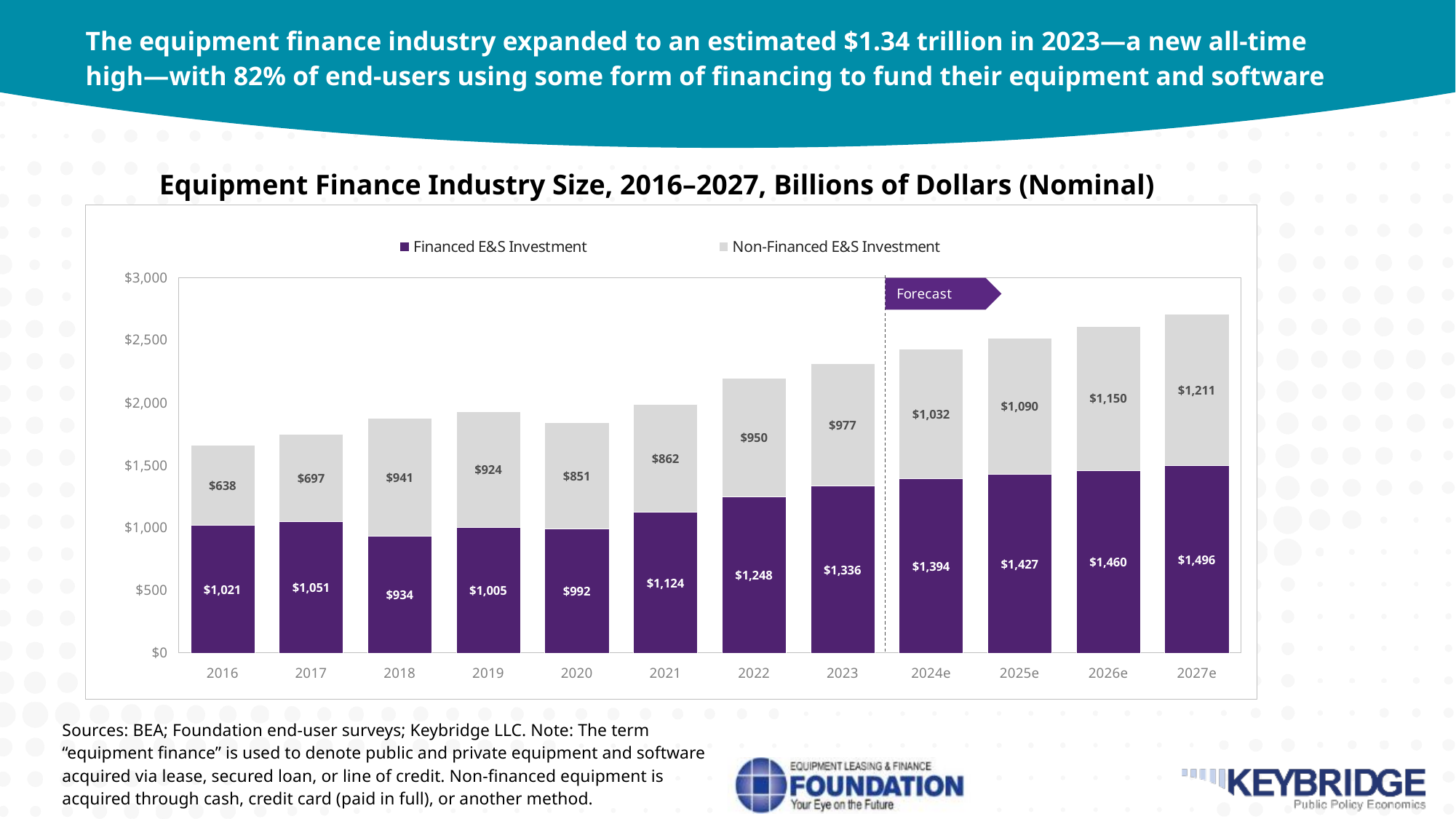
What is the Financed E&S Investment value for 2027e? $1,496 How many series does the legend list? 2 What is the difference between the Financed E&S Investment values for 2023 and 2016? $315 Which is larger, the Non-Financed E&S Investment value for 2018 or for 2020? 2018 What is the Non-Financed E&S Investment value for 2019? $924 What kind of chart is shown on the slide? Stacked bar chart What is the total of the stacked bar for 2016? $1,659 What is the Financed E&S Investment value for 2023? $1,336 What is the total of the stacked bar for 2023? $2,313 Which year has the highest Non-Financed E&S Investment value? 2027e Which year has the lowest Financed E&S Investment value? 2018 How many years are shown on the x axis? 12